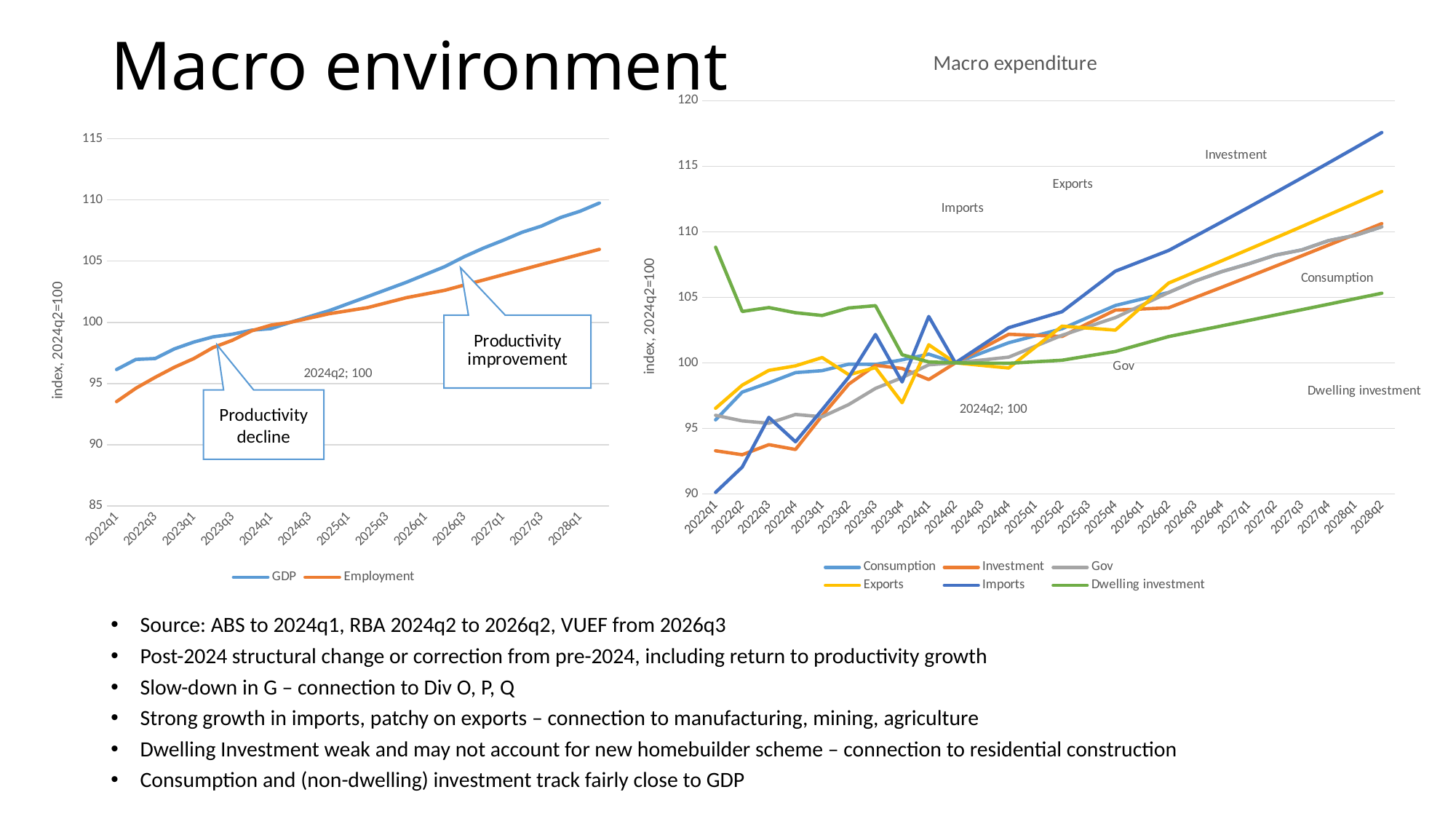
In the left chart, is the value for GDP at 2028q1 greater or less than 105? greater How many series does the legend of the Macro expenditure chart list? 6 In the Macro expenditure chart, which series has the lowest value at 2028q2? Dwelling investment What type of chart is the left chart showing GDP and Employment? line chart How many quarters are shown on the x axis of the Macro expenditure chart? 26 In the Macro expenditure chart, which series has the highest value at 2028q2? Imports How many series does the legend of the left chart list? 2 What is the title of the right chart? Macro expenditure In the left chart, what is the value of the index at 2024q2? 100 In the Macro expenditure chart, is the value for Imports at 2022q1 greater or less than 95? less In the left chart, which is higher at 2028q1, GDP or Employment? GDP In the left chart, do the GDP and Employment lines generally rise or fall from 2022q1 to 2028q1? rise